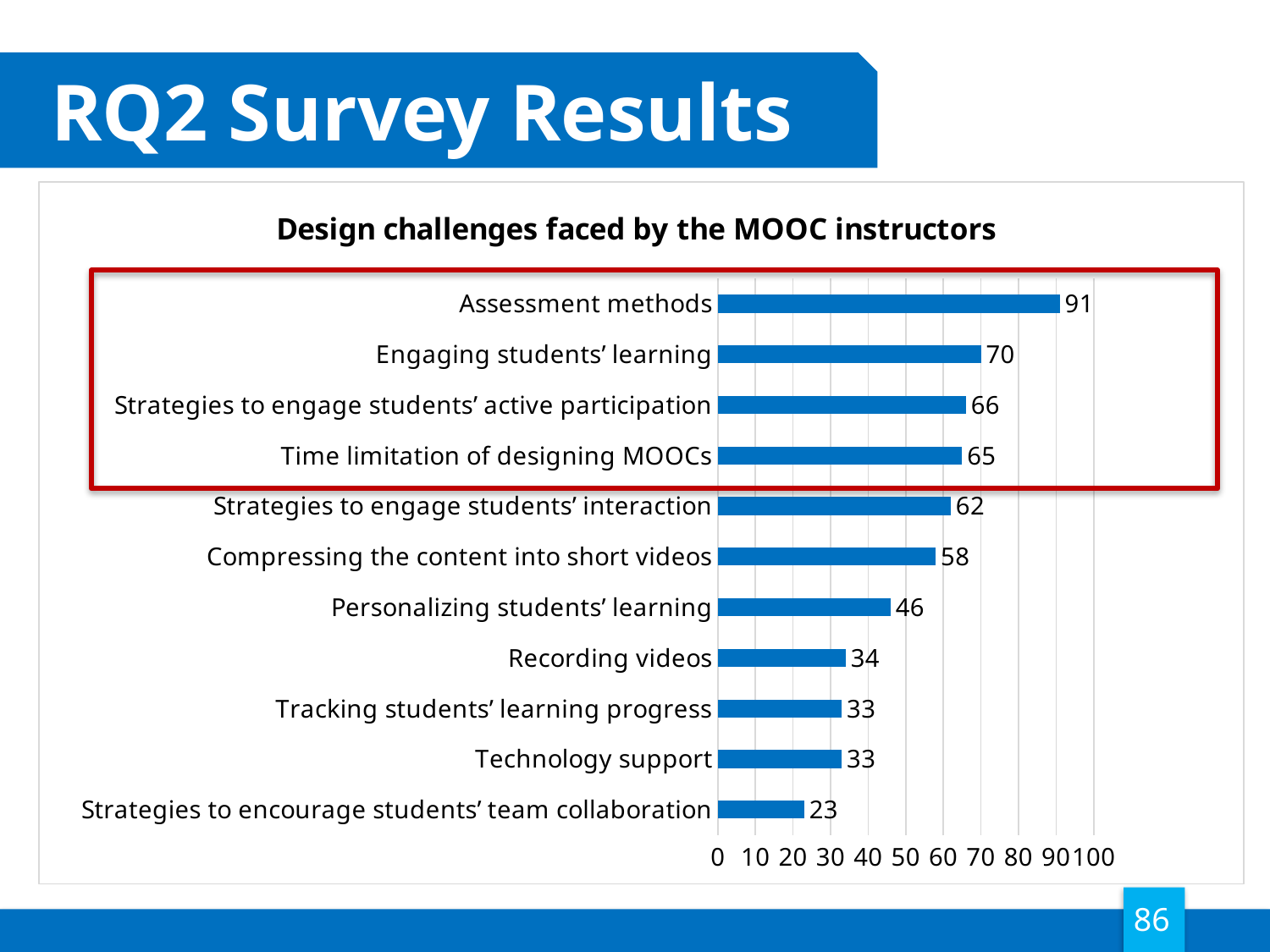
What is the difference between the values for Strategies to engage students' interaction and Strategies to encourage students' team collaboration? 39 Which is larger, the value for Recording videos or the value for Personalizing students' learning? Personalizing students' learning What is the difference between the values for Assessment methods and Engaging students' learning? 21 What is the value for Personalizing students' learning? 46 What kind of chart is shown on the slide? bar chart How many categories are shown in the chart? 11 Which category has the lowest value? Strategies to encourage students' team collaboration What is the value for Assessment methods? 91 What is the title of the chart? Design challenges faced by the MOOC instructors Is the value for Compressing the content into short videos greater or less than 50? greater What is the value for Time limitation of designing MOOCs? 65 Which category has the highest value? Assessment methods